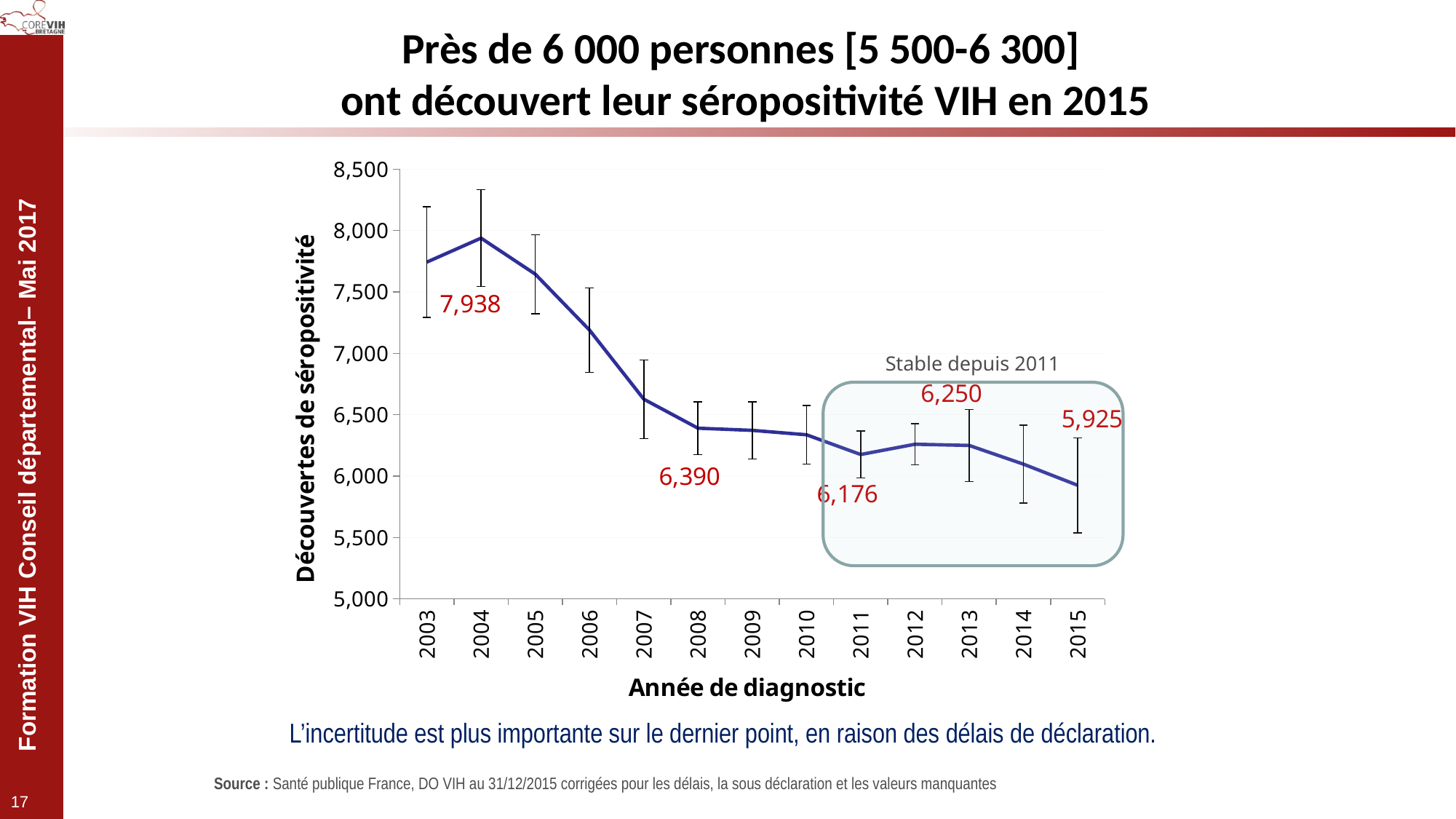
What kind of chart is shown? line chart What is the value for 2004? 7,938 Which year has the highest value? 2004 Is the value for 2007 greater or less than 7,000? less Which year has the lowest value? 2015 What is the value for 2015? 5,925 How many years are plotted on the x axis? 13 What is the value for 2008? 6,390 What is the difference between the values for 2004 and 2015? 2,013 What is the title of the x axis? Année de diagnostic Which is larger, the value for 2008 or the value for 2011? 2008